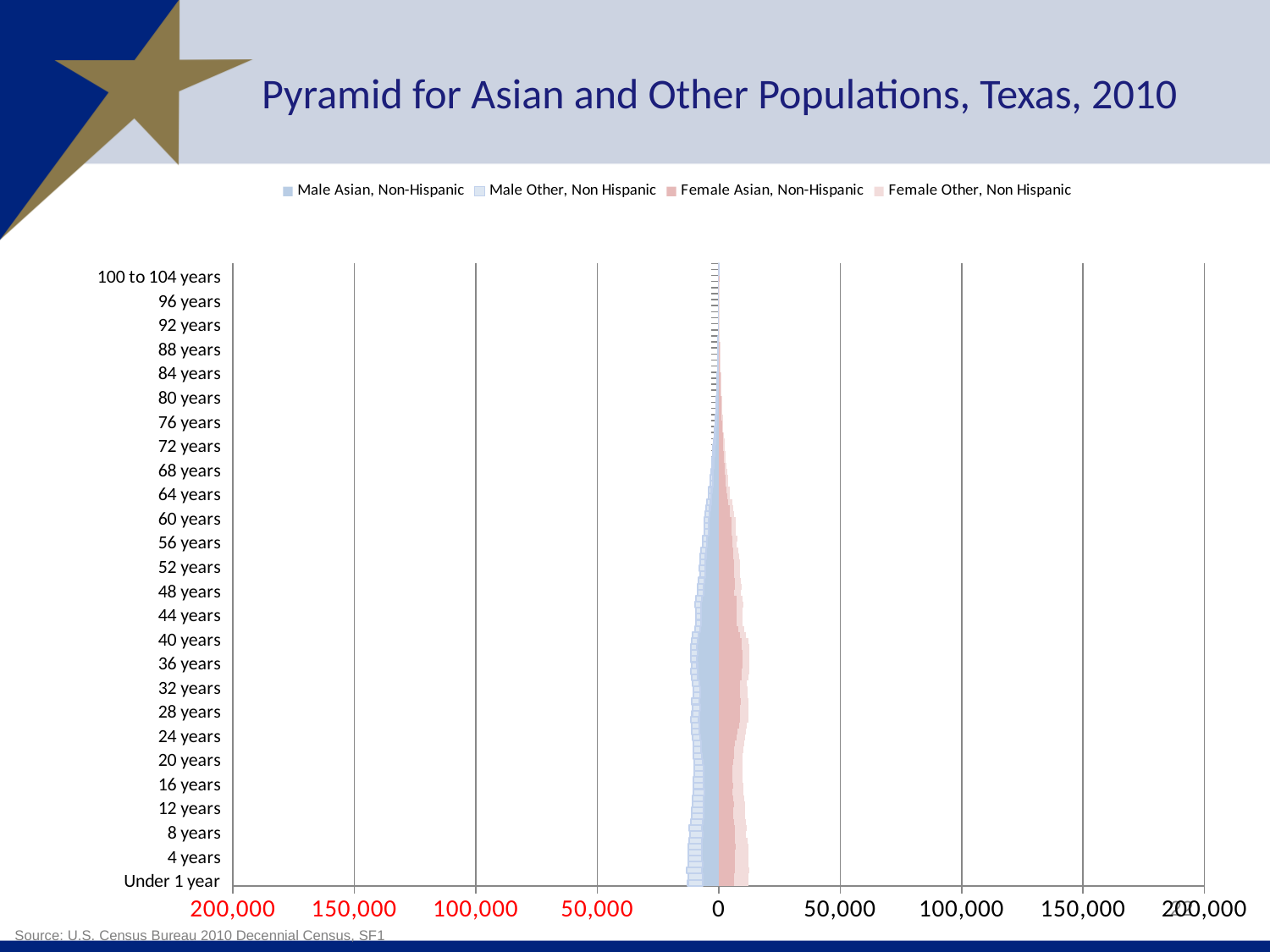
How many series does the legend list? 4 Is the value for Female Other, Non Hispanic at 8 years greater or less than 100,000? less Which is larger for Female Asian, Non-Hispanic: the value at 32 years or the value at 88 years? 32 years Which legend entry is listed first? Male Asian, Non-Hispanic Is the value for Male Asian, Non-Hispanic at 100 to 104 years greater or less than 50,000? less Is the value for Male Other, Non Hispanic at Under 1 year greater or less than 50,000? less Do the Male Asian, Non-Hispanic bars get longer or shorter moving from 100 to 104 years down toward 40 years? longer Which is larger for Male Asian, Non-Hispanic: the value at 40 years or the value at 96 years? 40 years What is the title of the chart? Pyramid for Asian and Other Populations, Texas, 2010 What kind of chart is shown on the slide? bar chart